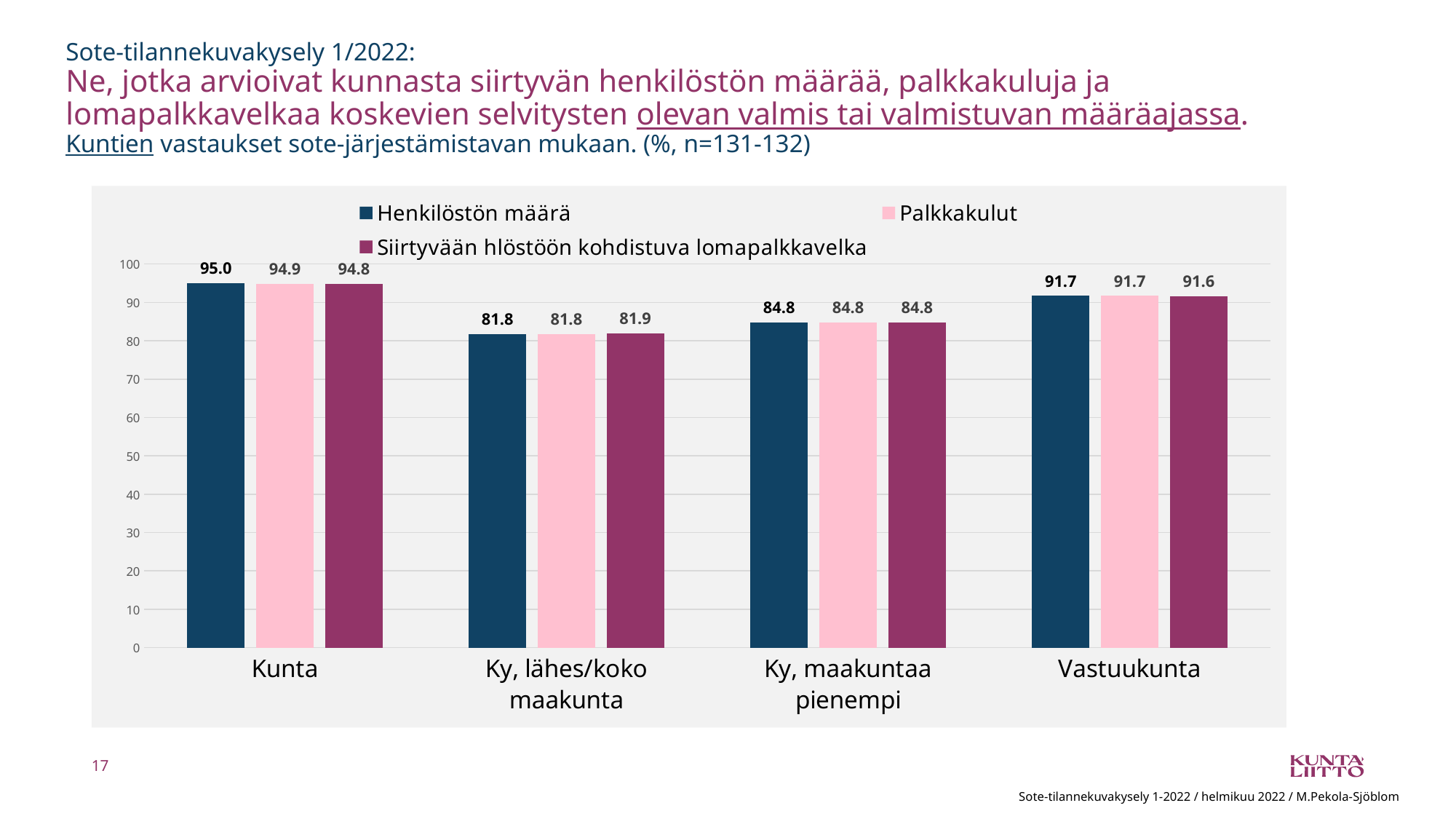
What is the value for Henkilöstön määrä in the Kunta category? 95.0 Is the value for Henkilöstön määrä in Ky, maakuntaa pienempi greater or less than 80? greater Which category has the lowest value for Palkkakulut? Ky, lähes/koko maakunta What colour are the bars for the Palkkakulut series? Light pink How many series does the legend list? 3 Which category has the highest value for Henkilöstön määrä? Kunta What is the difference between the Henkilöstön määrä values for Kunta and Ky, lähes/koko maakunta? 13.2 What kind of chart is shown on the slide? Bar chart What is the value for Siirtyvään hlöstöön kohdistuva lomapalkkavelka in the Ky, lähes/koko maakunta category? 81.9 Which is larger for Siirtyvään hlöstöön kohdistuva lomapalkkavelka: Vastuukunta or Ky, maakuntaa pienempi? Vastuukunta How many categories are shown on the x axis? 4 What is the value for Palkkakulut in the Vastuukunta category? 91.7